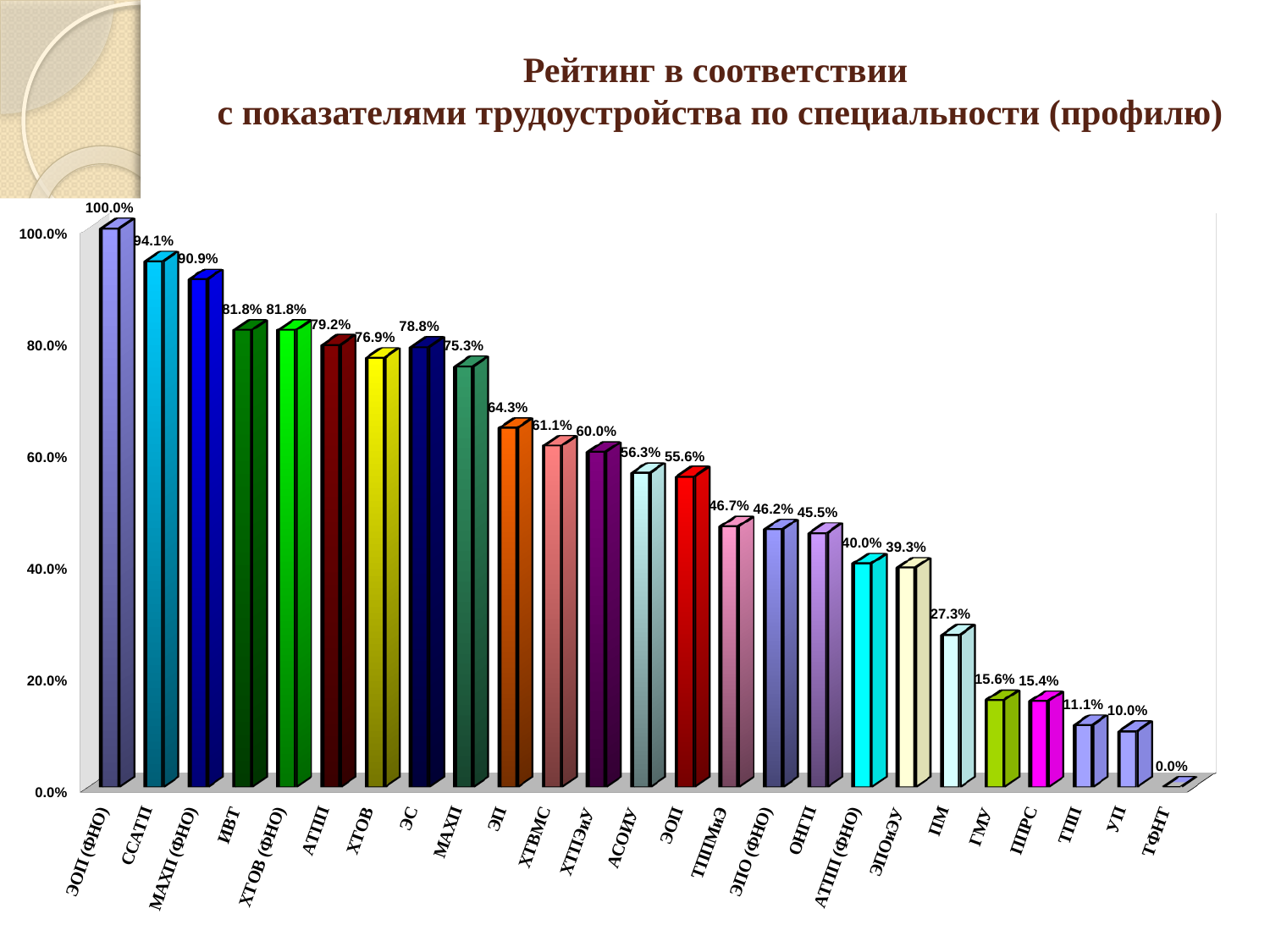
How many categories are shown on the chart? 25 What is the value for ССАТП? 94.1% Do the values generally rise or fall from left to right along the x axis? fall Which is larger, the value for ЭС or the value for ХТОВ? ЭС What is the value for ХТВМС? 61.1% What is the value for ПМ? 27.3% What is the title of the chart? Рейтинг в соответствии с показателями трудоустройства по специальности (профилю) Is the value for АСОИУ greater or less than 60.0%? less Which category has the lowest value? ТФНТ What is the difference between the values for ИВТ and ЭП? 17.5% Which category has the highest value? ЭОП (ФНО) What kind of chart is shown on the slide? bar chart